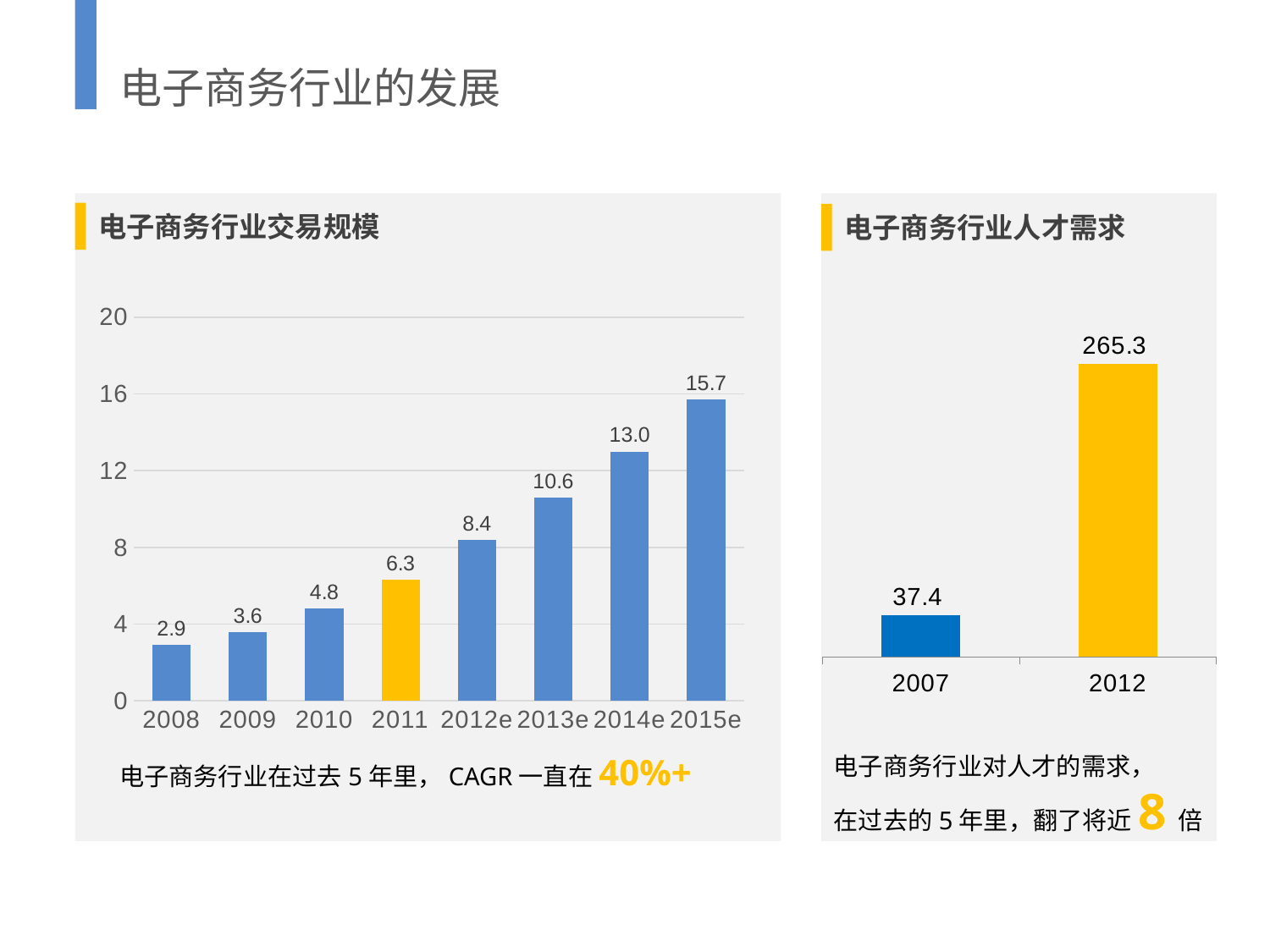
In the 电子商务行业交易规模 chart, which bar is coloured differently from the others? 2011 In the 电子商务行业人才需求 chart, what is the value for 2007? 37.4 In the 电子商务行业交易规模 chart, do the values rise or fall from 2008 to 2015e? rise In the 电子商务行业人才需求 chart, what is the difference between the values for 2012 and 2007? 227.9 In the 电子商务行业交易规模 chart, how many years are shown on the x axis? 8 In the 电子商务行业人才需求 chart, what is the value for 2012? 265.3 In the 电子商务行业交易规模 chart, which year has the highest value? 2015e In the 电子商务行业交易规模 chart, what is the difference between the values for 2014e and 2013e? 2.4 In the 电子商务行业交易规模 chart, what is the value for 2011? 6.3 In the 电子商务行业交易规模 chart, what is the value for 2015e? 15.7 What kind of chart is the 电子商务行业人才需求 chart? bar chart In the 电子商务行业交易规模 chart, which year has the lowest value? 2008